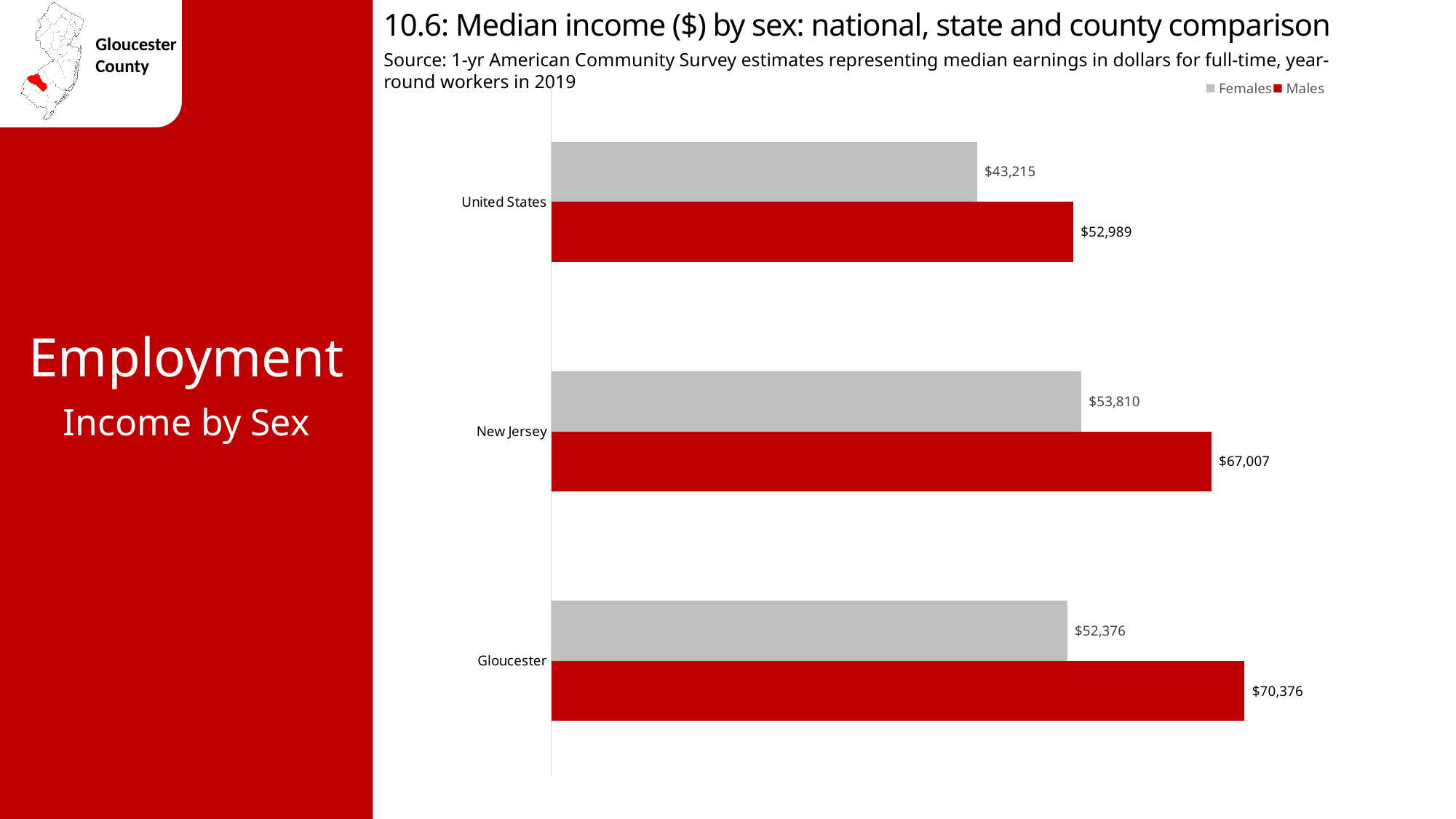
What is the difference between male and female median income in Gloucester? $18,000 How many series does the legend list? 2 Which geography has the lowest median income for females? United States Which is larger: the female median income in New Jersey or the male median income in the United States? Female median income in New Jersey What is the difference between male and female median income in the United States? $9,774 What is the median income for females in the United States? $43,215 Which geography has the highest median income for males? Gloucester What kind of chart is shown on the slide? Bar chart What is the median income for males in Gloucester? $70,376 What is the median income for females in Gloucester? $52,376 How many geographies are shown on the chart? 3 What is the median income for males in New Jersey? $67,007